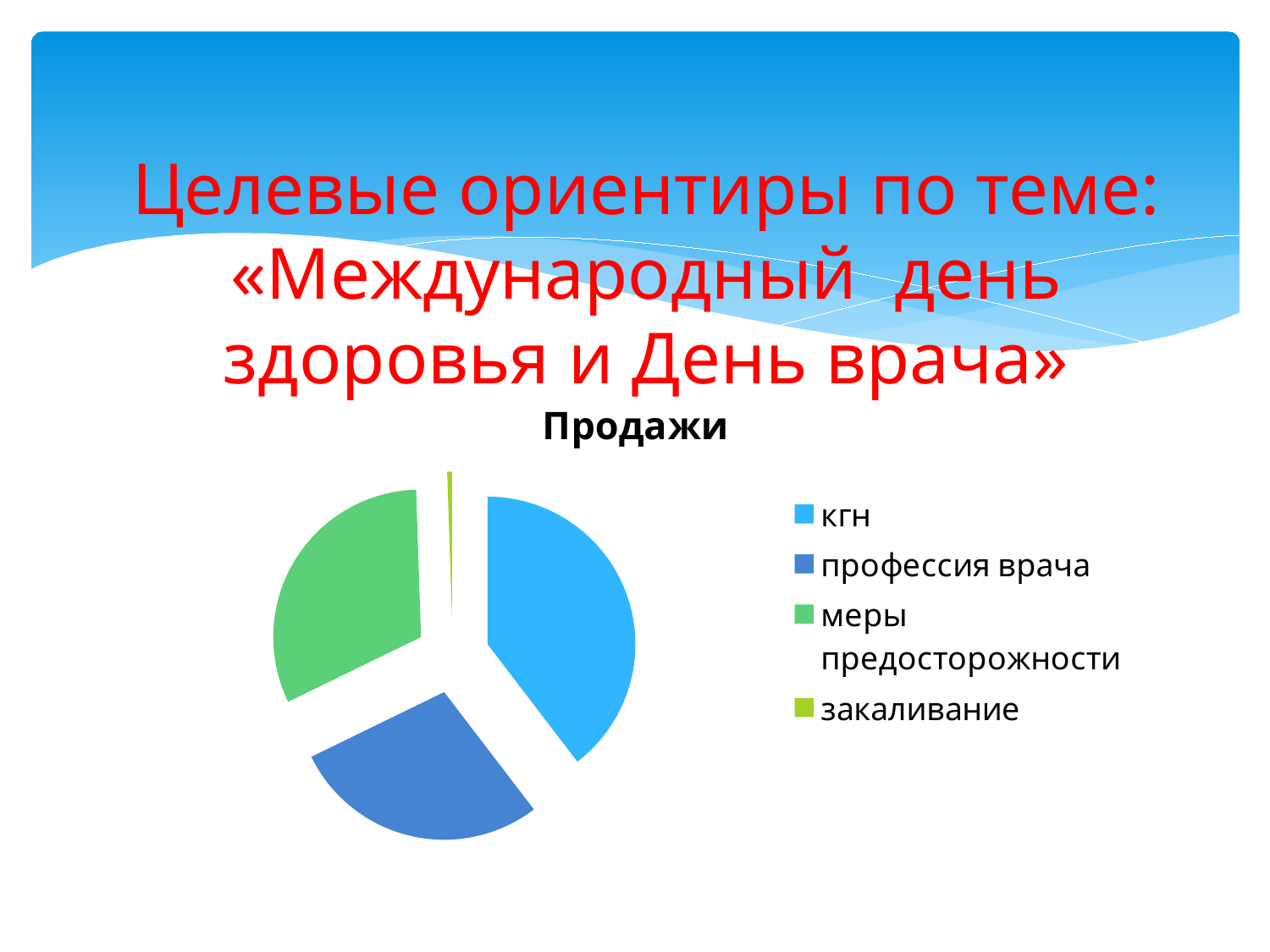
What kind of chart is shown on the slide? pie chart Which slice is larger, кгн or закаливание? кгн Which slice is larger, кгн or профессия врача? кгн Which category has the largest slice of the pie? кгн Which slice is larger, меры предосторожности or закаливание? меры предосторожности How many entries does the legend list? 4 Which category has the smallest slice of the pie? закаливание What colour is the slice for кгн? light blue How many categories does the pie chart have? 4 What is the title of the chart? Продажи